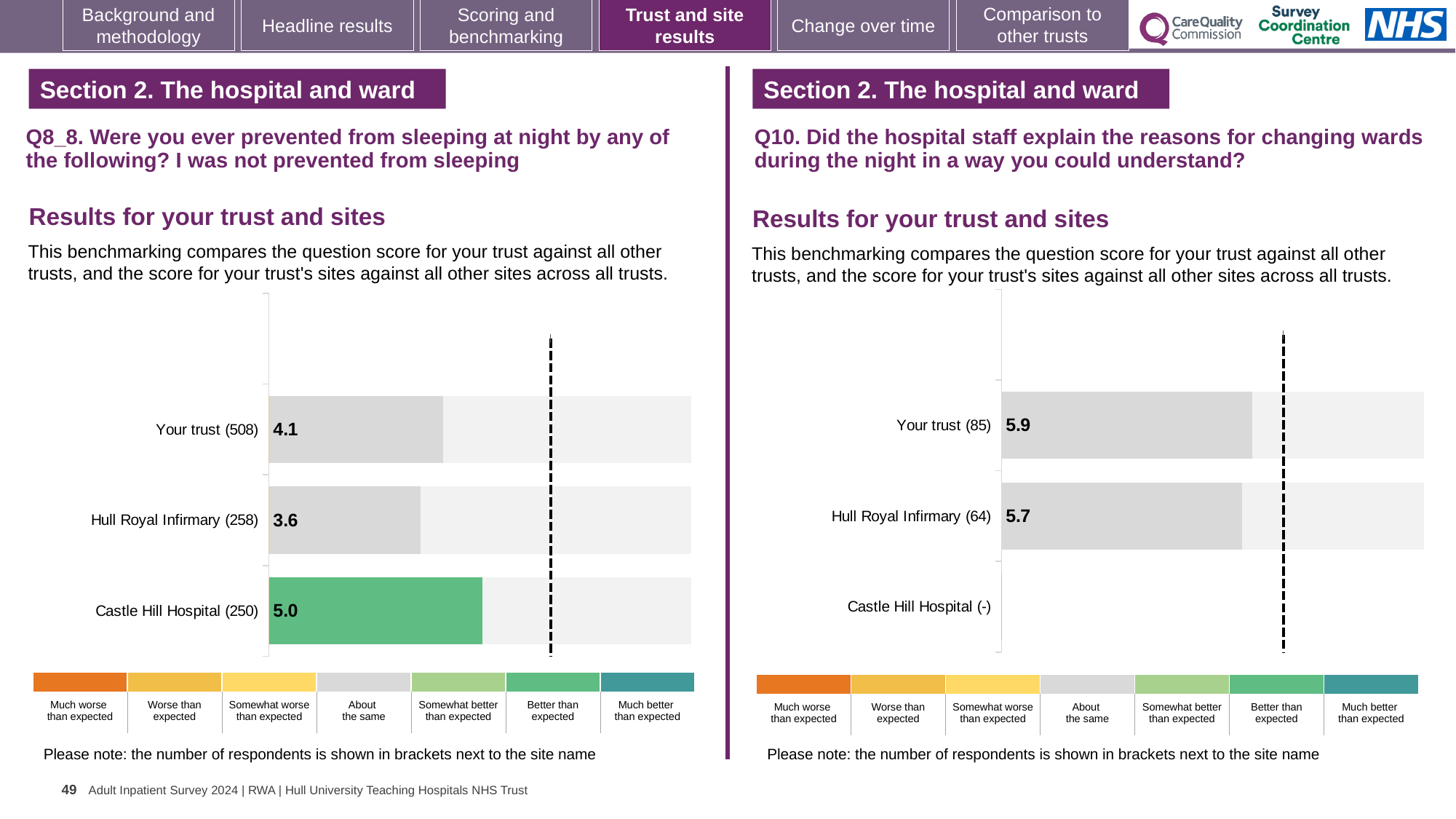
In the Q8_8 chart on the left, what is the difference between the scores for Castle Hill Hospital and Hull Royal Infirmary? 1.4 In the Q8_8 chart on the left, what is the score for Castle Hill Hospital? 5.0 In the Q8_8 chart on the left, what is the score for Hull Royal Infirmary? 3.6 In the Q8_8 chart on the left, which site or trust has the highest score? Castle Hill Hospital In the Q8_8 chart on the left, which bar is coloured green rather than grey? Castle Hill Hospital In the Q10 chart on the right, what is the difference between the scores for Your trust and Hull Royal Infirmary? 0.2 In the Q8_8 chart on the left, what is the score for Your trust? 4.1 What kind of chart is used on the left for Q8_8? Bar chart In the Q10 chart on the right, what is the score for Your trust? 5.9 In the Q10 chart on the right, what is the score for Hull Royal Infirmary? 5.7 In the Q8_8 chart on the left, how many respondents are shown for Castle Hill Hospital? 250 In the Q8_8 chart on the left, which site or trust has the lowest score? Hull Royal Infirmary